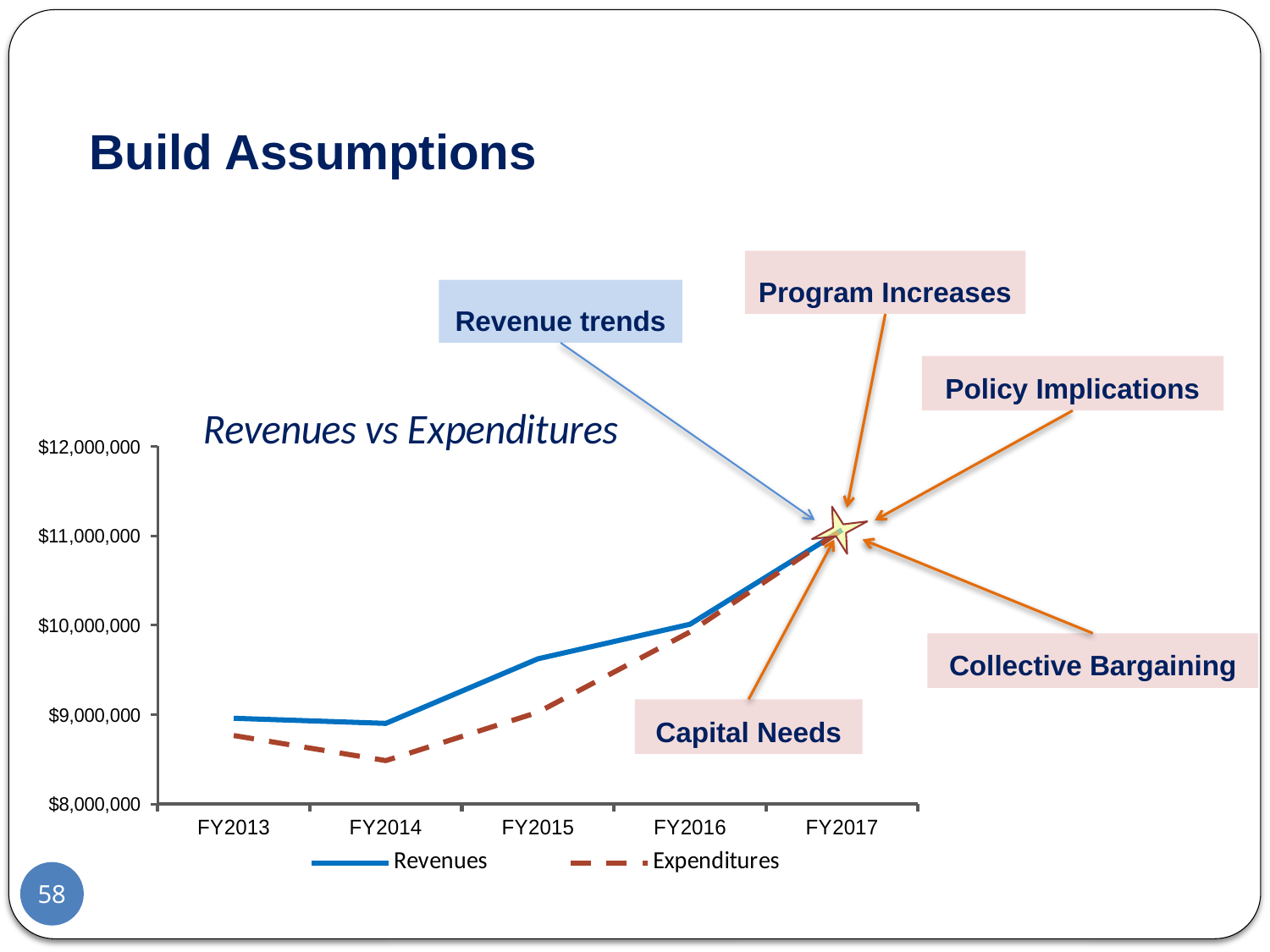
How many series does the chart's legend list? 2 How many fiscal years are plotted along the x axis? 5 Is the value for Revenues in FY2015 greater or less than $10,000,000? less What is the title of the chart? Revenues vs Expenditures Do Expenditures rise or fall from FY2014 to FY2017? rise What kind of chart is shown on the slide? line chart In which fiscal year are Expenditures lowest? FY2014 In which fiscal year are Revenues highest? FY2017 In FY2015, which is larger, Revenues or Expenditures? Revenues Is the value for Expenditures in FY2014 greater or less than $9,000,000? less Which series is drawn with a dashed line? Expenditures